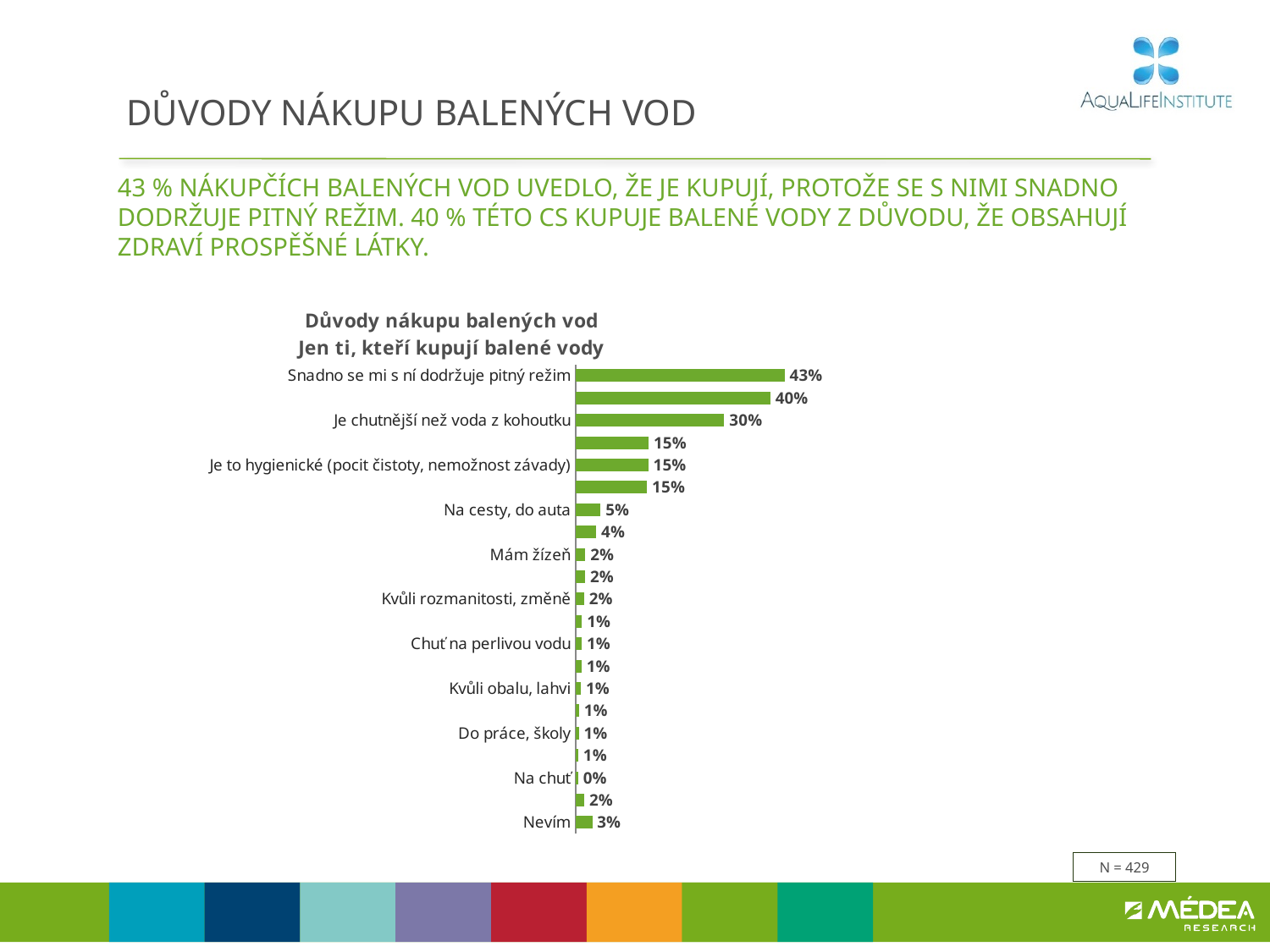
Which is larger, the value for "Nevím" or the value for "Mám žízeň"? Nevím What is the value for "Nevím"? 3% What kind of chart is shown on the slide? bar chart What is the value for "Je chutnější než voda z kohoutku"? 30% What is the difference between the values for "Snadno se mi s ní dodržuje pitný režim" and "Je chutnější než voda z kohoutku"? 13 percentage points What is the second line of the chart title? Jen ti, kteří kupují balené vody Which labelled category has the lowest value? Na chuť What is the value for "Na cesty, do auta"? 5% Which labelled category has the highest value? Snadno se mi s ní dodržuje pitný režim How many bars are plotted in the chart? 21 What is the value for "Snadno se mi s ní dodržuje pitný režim"? 43% What is the value for "Je to hygienické (pocit čistoty, nemožnost závady)"? 15%